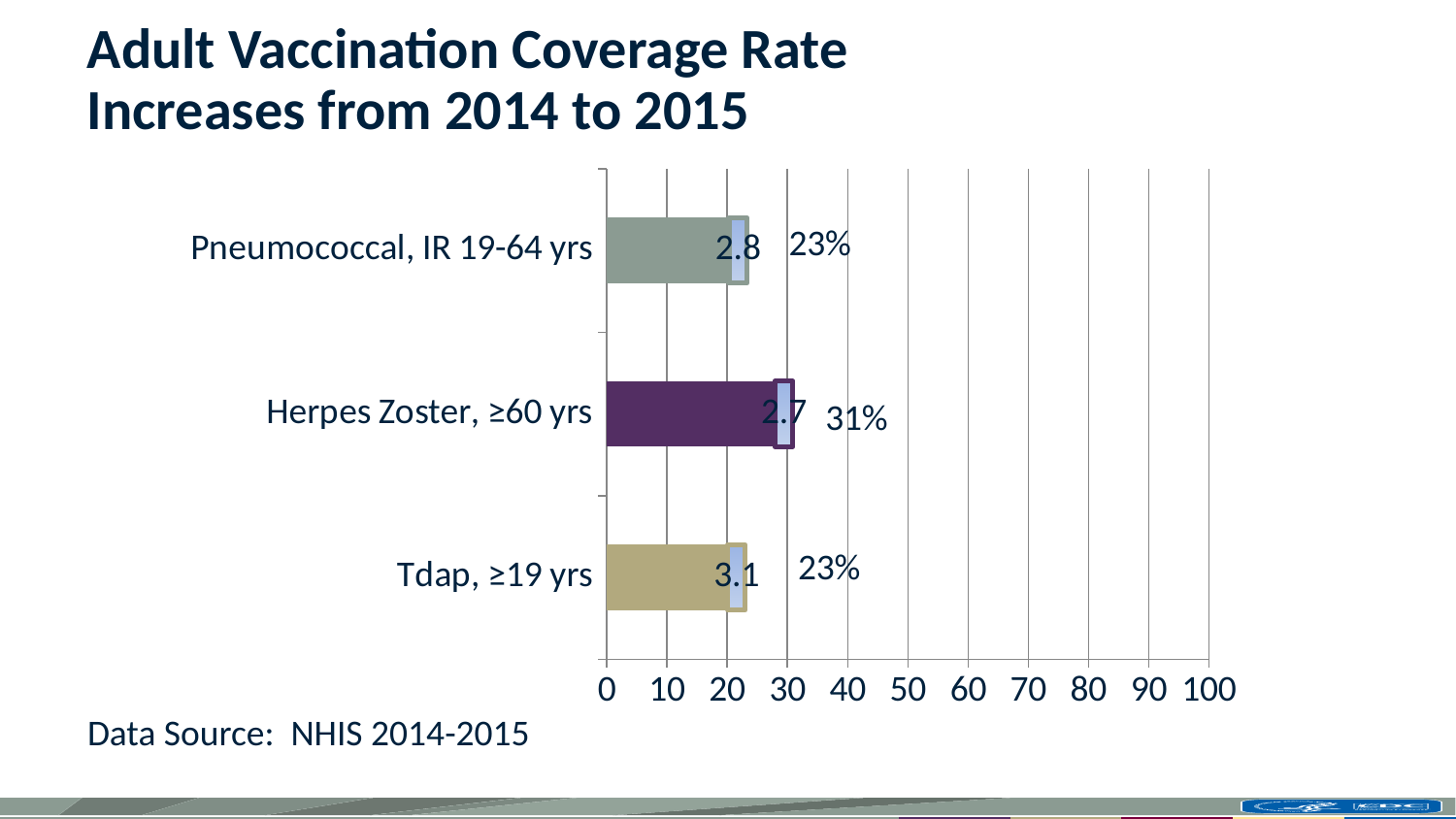
Which vaccine category shows the smallest increase value? Herpes Zoster, ≥60 yrs What is the 2015 coverage rate shown for Herpes Zoster, ≥60 yrs? 31% What increase value is labelled on the Tdap, ≥19 yrs bar? 3.1 Which has a higher coverage rate, Herpes Zoster, ≥60 yrs or Pneumococcal, IR 19-64 yrs? Herpes Zoster, ≥60 yrs What increase value is labelled on the Herpes Zoster, ≥60 yrs bar? 2.7 What is the coverage rate shown for Pneumococcal, IR 19-64 yrs? 23% What is the difference in coverage rate between Herpes Zoster, ≥60 yrs and Tdap, ≥19 yrs? 8 percentage points Which vaccine category shows the largest increase value? Tdap, ≥19 yrs Which vaccine category has the highest coverage rate? Herpes Zoster, ≥60 yrs What type of chart is shown on the slide? Bar chart Is the coverage rate for Pneumococcal, IR 19-64 yrs greater or less than 30? less How many vaccine categories are shown in the chart? 3